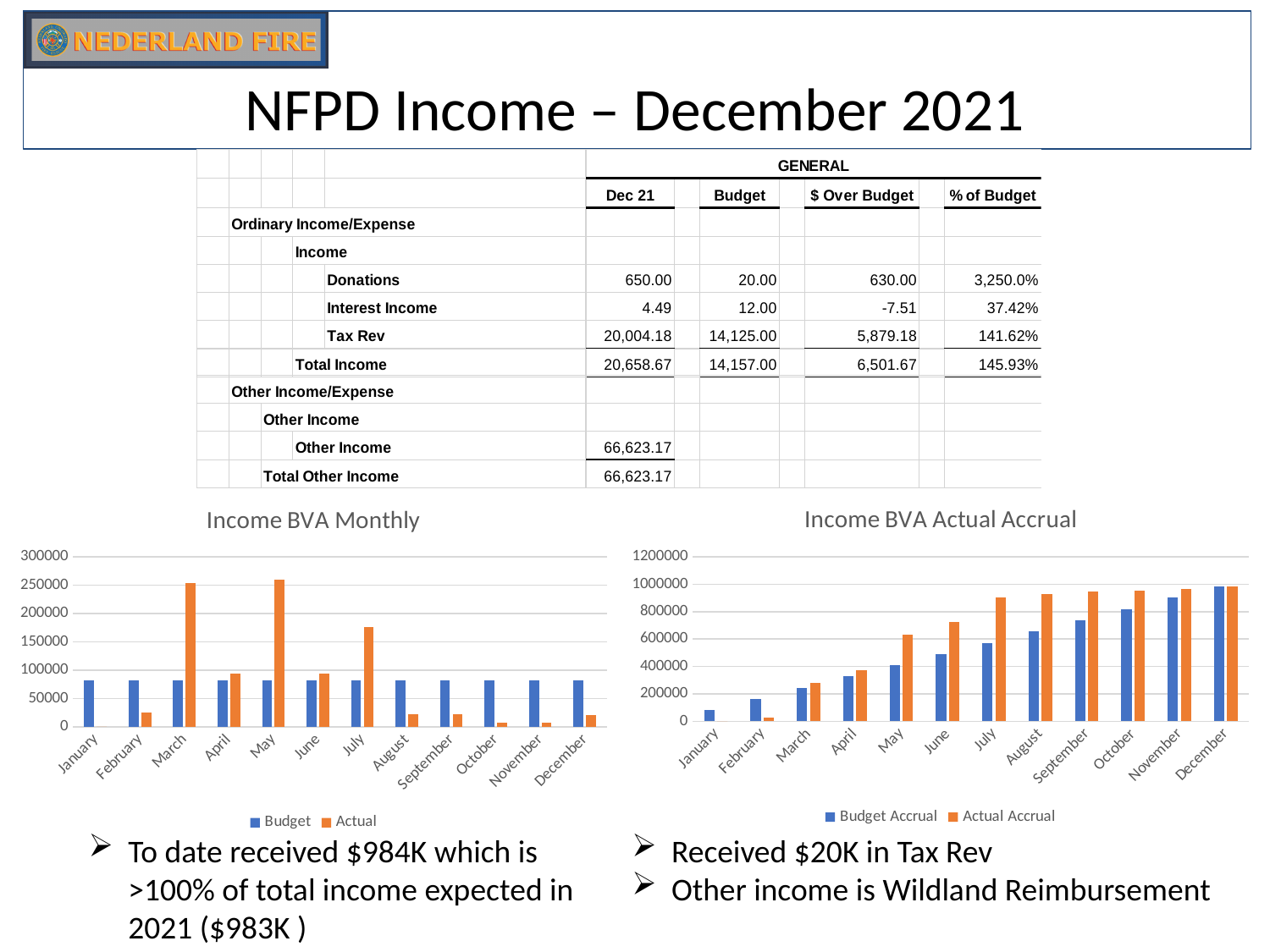
In the "Income BVA Monthly" chart, which is larger for March, Budget or Actual? Actual In the "Income BVA Monthly" chart, is the Actual value for March greater or less than 200000? greater What kind of chart is the "Income BVA Monthly" chart? bar chart In the "Income BVA Actual Accrual" chart, do the Budget Accrual values rise or fall from January to December? rise In the "Income BVA Monthly" chart, is the Budget value for January greater or less than 100000? less What are the two legend entries of the "Income BVA Actual Accrual" chart? Budget Accrual and Actual Accrual In the "Income BVA Monthly" chart, is the Actual value for February greater or less than 50000? less In the "Income BVA Monthly" chart, which is larger for September, Budget or Actual? Budget In the "Income BVA Actual Accrual" chart, which is larger for July, Budget Accrual or Actual Accrual? Actual Accrual How many series does the legend of the "Income BVA Actual Accrual" chart list? 2 How many months are shown on the x axis of the "Income BVA Monthly" chart? 12